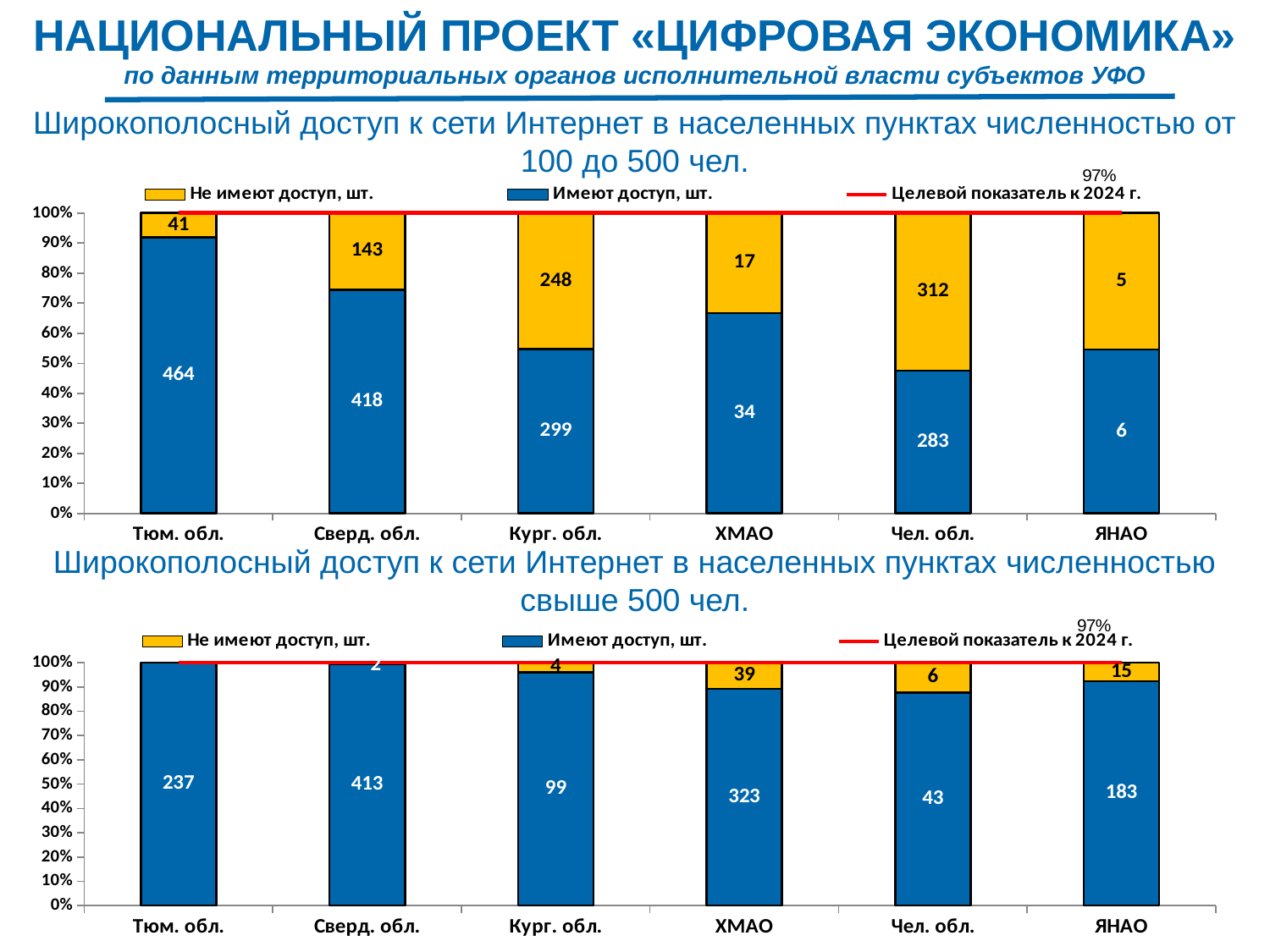
In the bottom chart (свыше 500 чел.), which is larger: «Имеют доступ, шт.» for Сверд. обл. or for ЯНАО? Сверд. обл. What type of chart is used for the top chart (от 100 до 500 чел.)? Stacked bar chart In the top chart (от 100 до 500 чел.), what is the difference between «Не имеют доступ, шт.» and «Имеют доступ, шт.» for Чел. обл.? 29 How many regions are shown on the x axis of the top chart? 6 In the top chart (от 100 до 500 чел.), which region has the highest value of «Имеют доступ, шт.»? Тюм. обл. In the bottom chart (свыше 500 чел.), what is the value of «Имеют доступ, шт.» for ХМАО? 323 In the top chart (от 100 до 500 чел.), what is the total number of settlements (имеют + не имеют доступ) for Сверд. обл.? 561 In the bottom chart (свыше 500 чел.), what is the value of «Не имеют доступ, шт.» for ЯНАО? 15 In the top chart (населенные пункты от 100 до 500 чел.), what is the value of «Имеют доступ, шт.» for Тюм. обл.? 464 How many series does the legend of the bottom chart list? 3 In the bottom chart (свыше 500 чел.), which region has the lowest value of «Имеют доступ, шт.»? Чел. обл. In the top chart (от 100 до 500 чел.), what is the value of «Не имеют доступ, шт.» for Кург. обл.? 248